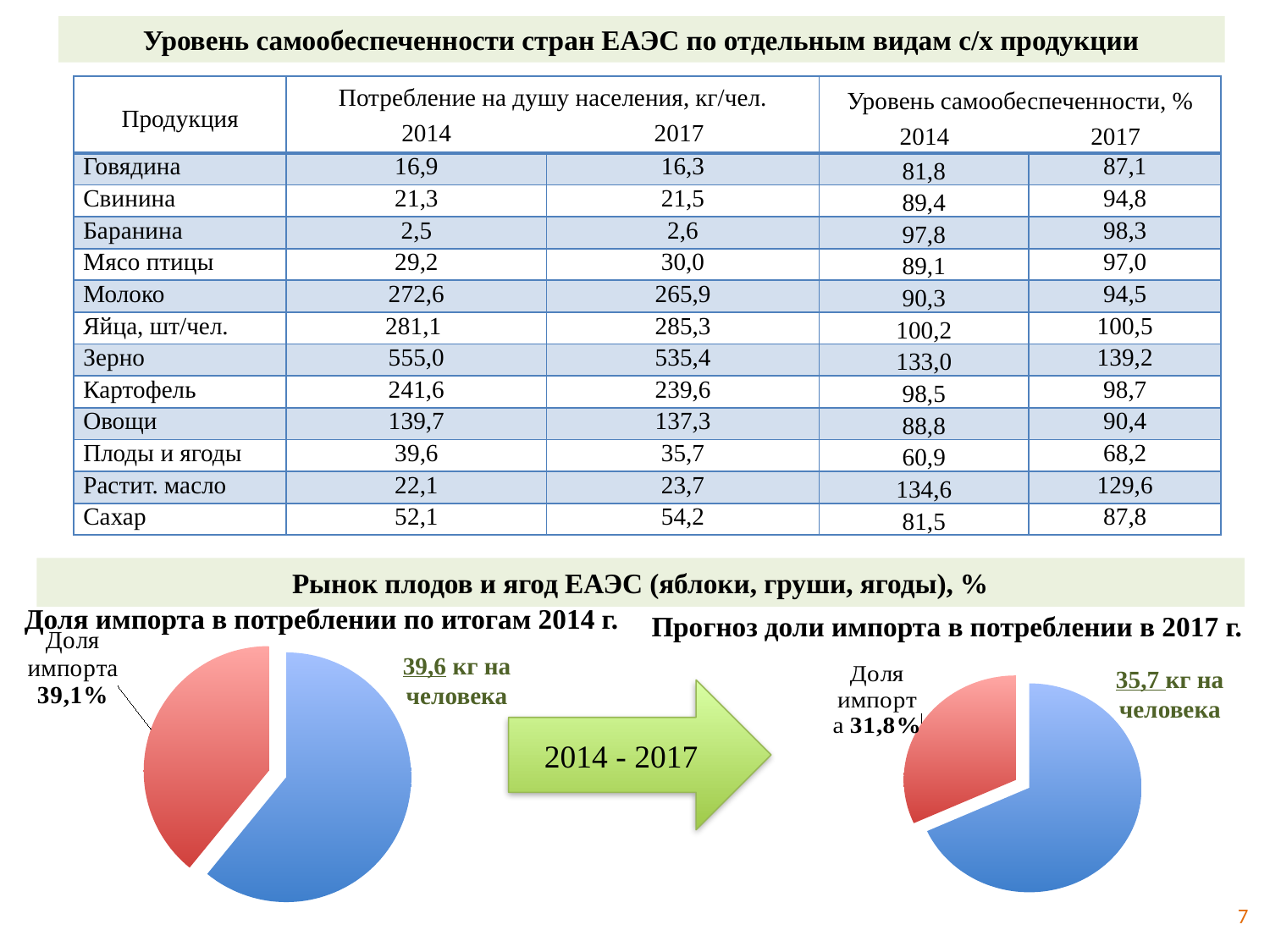
In the 2014 pie chart (left), what is the share of imports in consumption (Доля импорта)? 39,1% Which pie chart shows the larger import share: the 2014 chart or the 2017 forecast chart? 2014 What per-person consumption figure is annotated next to the 2017 forecast pie chart (right)? 35,7 кг на человека How many slices does the 2014 pie chart (left) have? 2 What colour is the import share slice in the two pie charts? red Is the import share in the 2014 pie chart greater or less than 50%? less Does the import share rise or fall from the 2014 pie chart to the 2017 forecast pie chart? falls By how many percentage points does the import share in the 2017 forecast pie chart differ from the 2014 pie chart? 7,3 What kind of chart is used for 'Доля импорта в потреблении по итогам 2014 г.'? pie chart What per-person consumption figure is annotated next to the 2014 pie chart (left)? 39,6 кг на человека In the 2017 forecast pie chart (right), what is the forecast share of imports in consumption? 31,8% What is the heading above the two pie charts? Рынок плодов и ягод ЕАЭС (яблоки, груши, ягоды), %